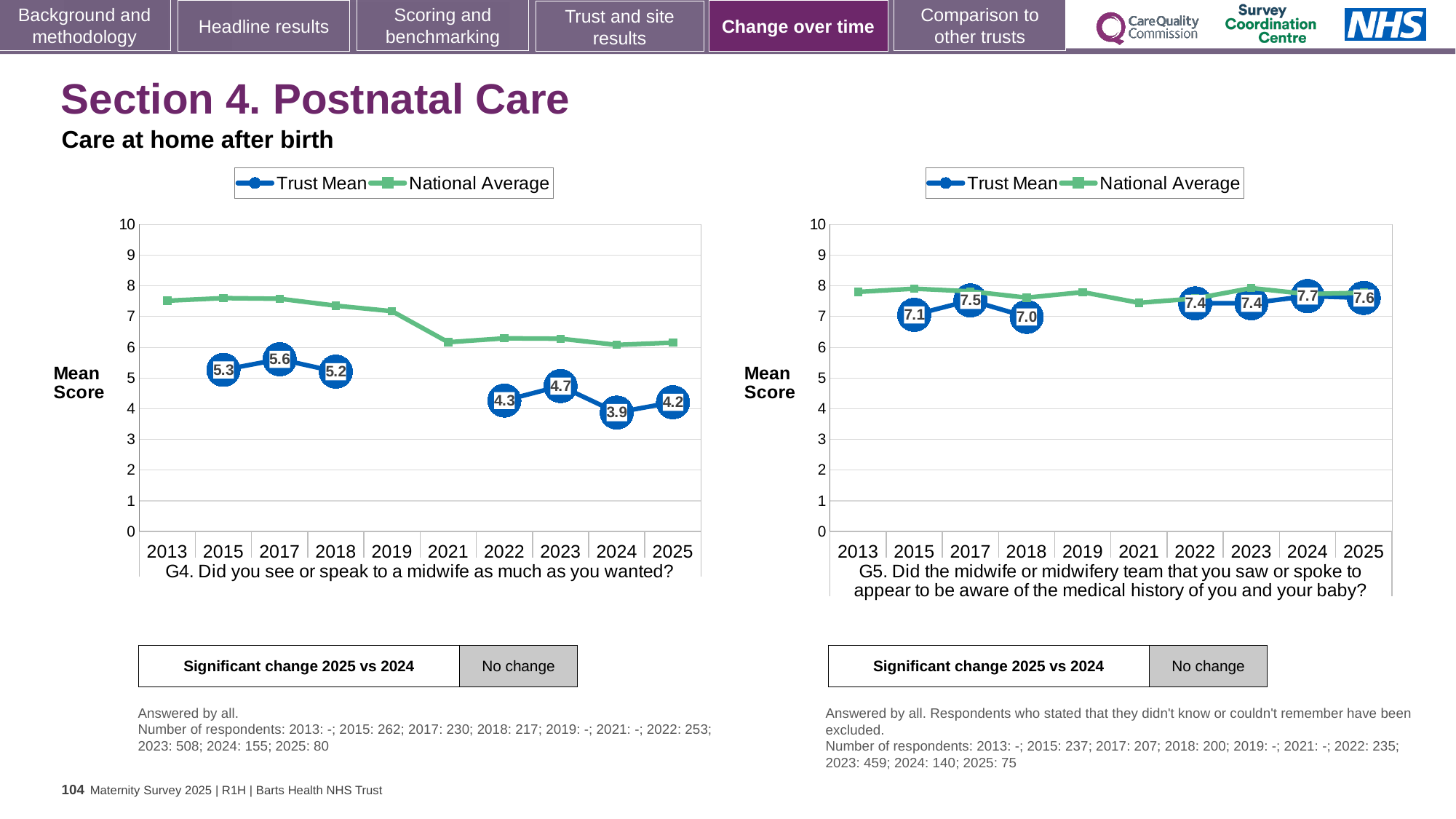
How many series does the legend of the G5 chart (right) list? 2 In the G4 chart (left), what is the Trust Mean score for 2017? 5.6 In the G5 chart (right), which year has the highest Trust Mean score? 2024 In the G5 chart (right), what is the Trust Mean score for 2018? 7.0 In the G5 chart (right), what is the difference between the Trust Mean scores for 2024 and 2018? 0.7 In the G4 chart (left), does the National Average rise or fall from 2019 to 2021? Fall In the G4 chart (left), is the National Average for 2013 greater or less than 7? greater In the G4 chart (left), what is the Trust Mean score for 2025? 4.2 What kind of chart is the G4 chart (left)? Line chart In the G4 chart (left), which is larger: the Trust Mean for 2015 or the Trust Mean for 2022? 2015 In the G4 chart (left), which year has the lowest Trust Mean score? 2024 In the G4 chart (left), what is the difference between the Trust Mean scores for 2017 and 2024? 1.7